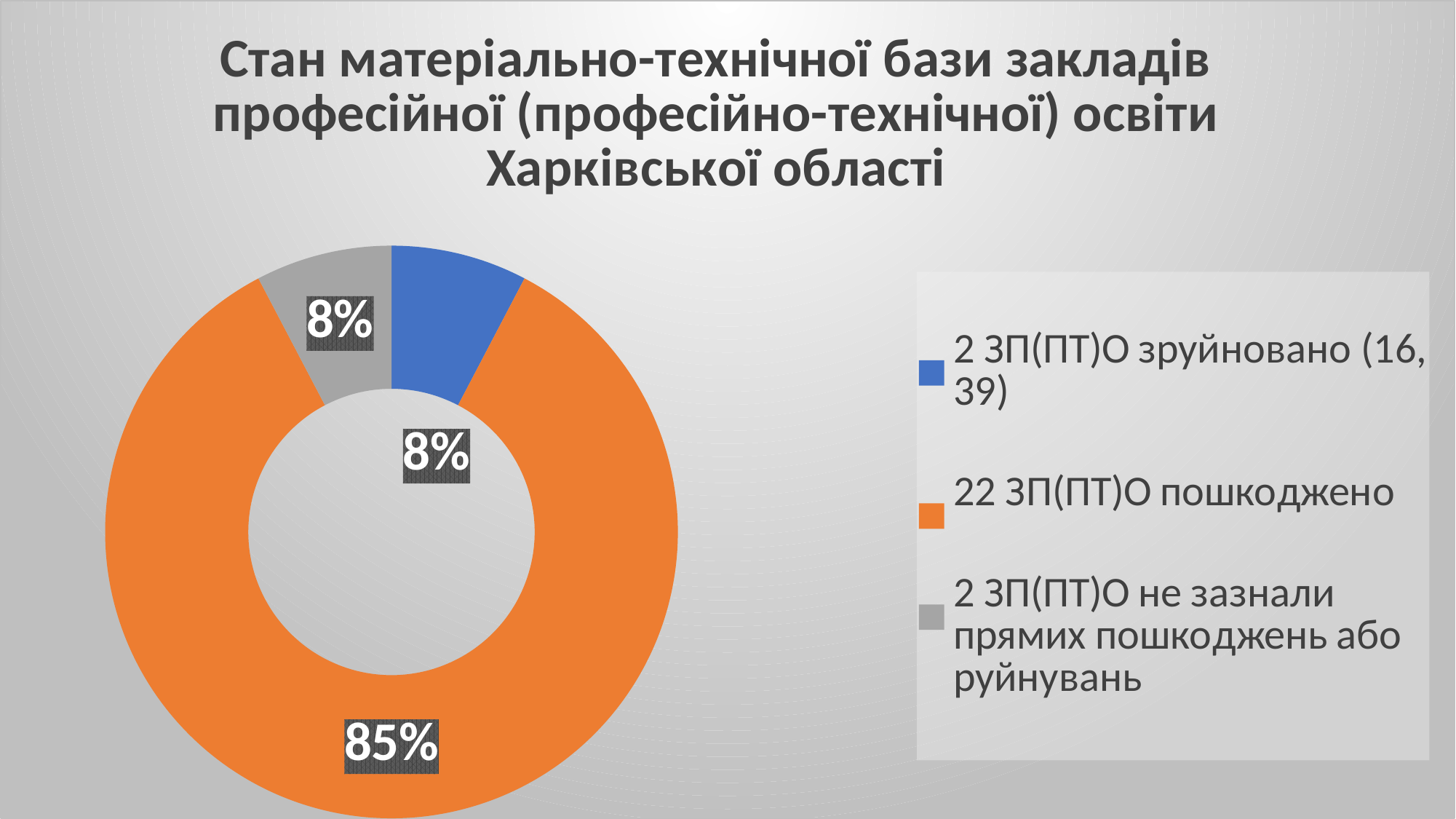
How many slices does the chart have? 3 What percentage is shown for the slice "2 ЗП(ПТ)О зруйновано (16, 39)"? 8% What is the difference in percentage points between "22 ЗП(ПТ)О пошкоджено" and "2 ЗП(ПТ)О зруйновано (16, 39)"? 77 percentage points What percentage is shown for the slice "2 ЗП(ПТ)О не зазнали прямих пошкоджень або руйнувань"? 8% What percentage is shown for the slice "22 ЗП(ПТ)О пошкоджено"? 85% Is the share for "22 ЗП(ПТ)О пошкоджено" greater or less than 50%? greater Which is larger: the share for "22 ЗП(ПТ)О пошкоджено" or the share for "2 ЗП(ПТ)О не зазнали прямих пошкоджень або руйнувань"? 22 ЗП(ПТ)О пошкоджено What is the title of the slide? Стан матеріально-технічної бази закладів професійної (професійно-технічної) освіти Харківської області What colour is the slice for "2 ЗП(ПТ)О зруйновано (16, 39)"? Blue What kind of chart is shown on the slide? Doughnut (pie) chart Which category has the largest share of the chart? 22 ЗП(ПТ)О пошкоджено How many entries does the legend list? 3